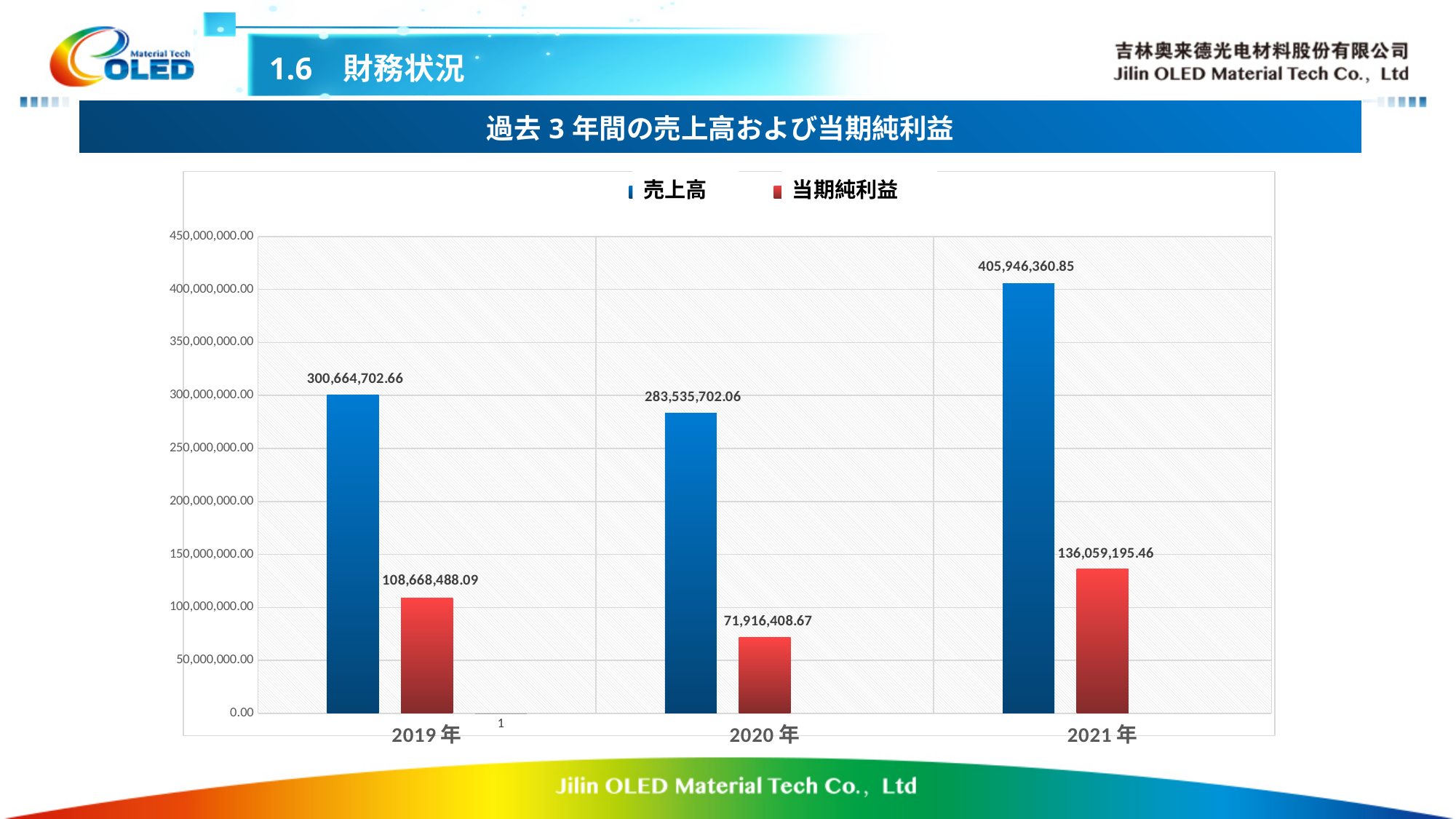
What type of chart is shown on the slide? Bar chart What is the 当期純利益 value for 2020年? 71,916,408.67 What is the difference between the 売上高 for 2021年 and 2020年? 122,410,658.79 Which is larger, the 売上高 for 2019年 or for 2020年? 2019年 Which year has the highest 売上高? 2021年 What is the difference between the 当期純利益 for 2021年 and 2019年? 27,390,707.37 How many series does the legend list? 2 What is the 売上高 value for 2021年? 405,946,360.85 Which year has the lowest 当期純利益? 2020年 What is the 売上高 value for 2019年? 300,664,702.66 How many years are shown on the x axis? 3 Which series is shown in red in the legend? 当期純利益